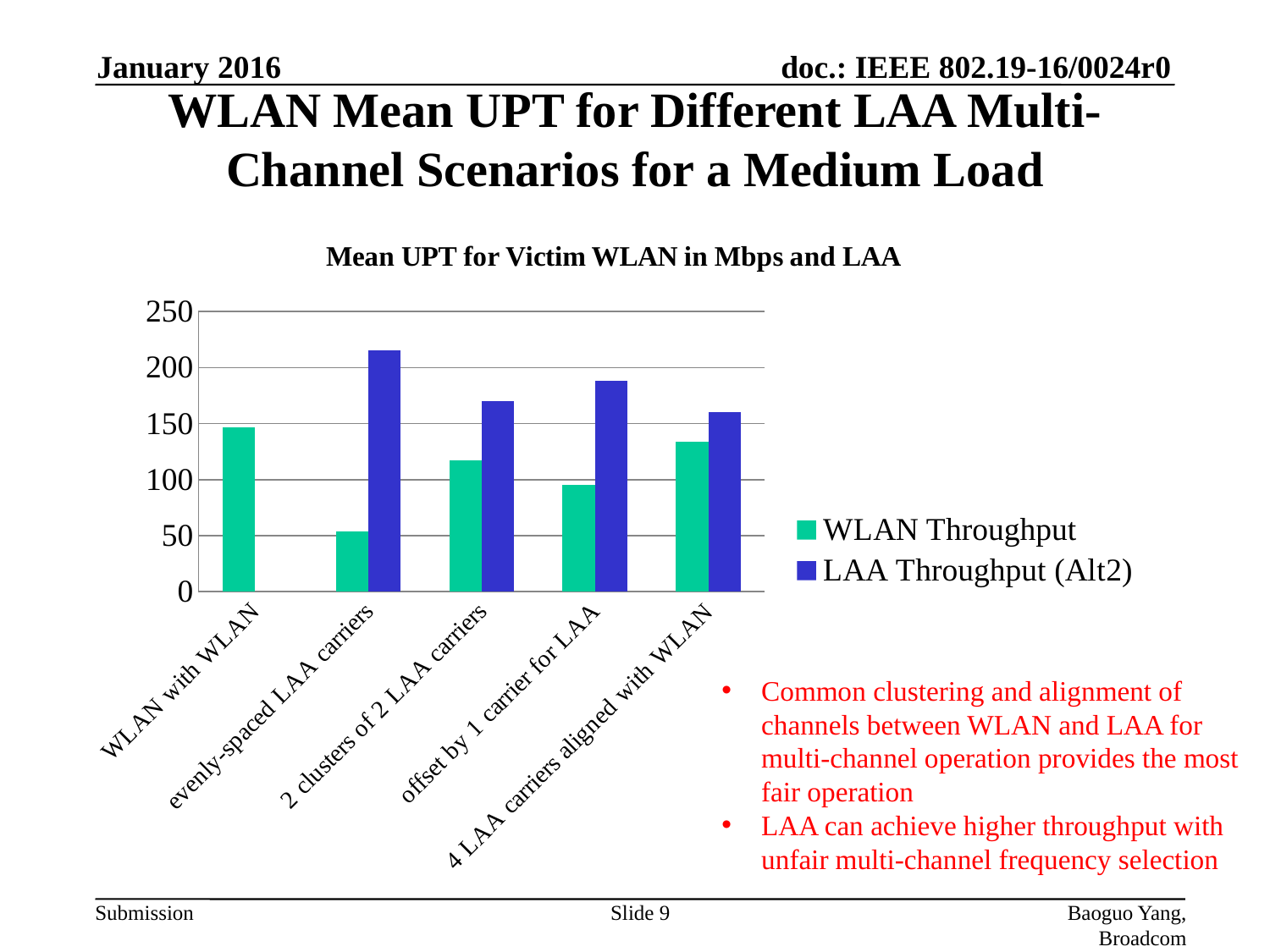
Which category has the lowest WLAN Throughput? evenly-spaced LAA carriers What kind of chart is shown on the slide? bar chart How many categories are shown on the x axis? 5 How many series does the legend list? 2 Is the WLAN Throughput for evenly-spaced LAA carriers greater or less than 100? less Is the LAA Throughput (Alt2) for evenly-spaced LAA carriers greater or less than 200? greater Which category has the highest LAA Throughput (Alt2)? evenly-spaced LAA carriers Which series is shown in blue in the legend? LAA Throughput (Alt2) Which category has the highest WLAN Throughput? WLAN with WLAN What is the title of the chart? Mean UPT for Victim WLAN in Mbps and LAA Is the WLAN Throughput for 2 clusters of 2 LAA carriers greater or less than 150? less For evenly-spaced LAA carriers, which is larger: WLAN Throughput or LAA Throughput (Alt2)? LAA Throughput (Alt2)